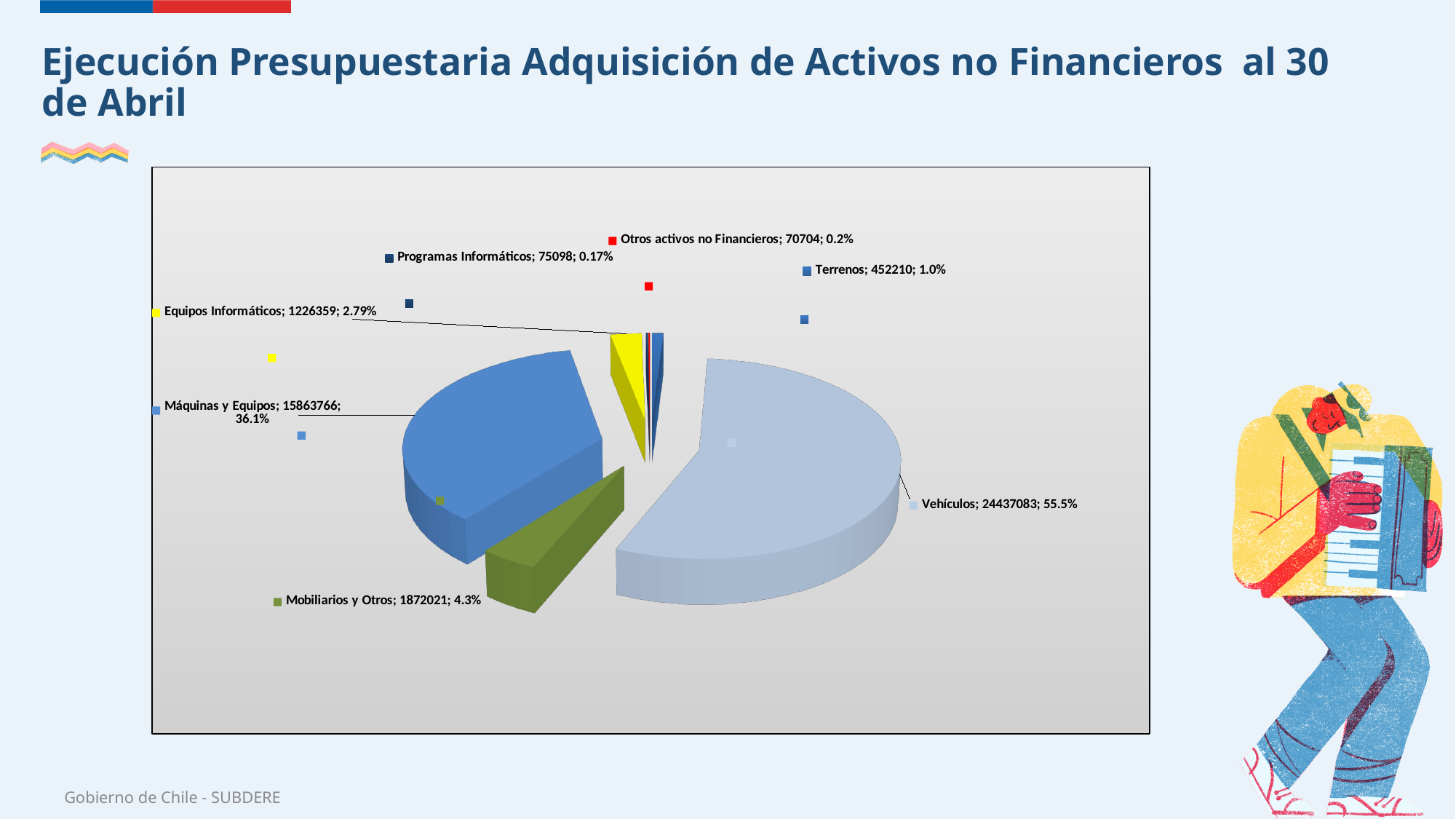
What percentage is shown for Programas Informáticos? 0.17% What share of the pie does Máquinas y Equipos represent? 36.1% What percentage is shown for Equipos Informáticos? 2.79% What kind of chart is shown on the slide? pie chart Which category has the largest slice of the pie? Vehículos Which is larger, the value for Mobiliarios y Otros or the value for Equipos Informáticos? Mobiliarios y Otros Which category has the smallest value? Otros activos no Financieros What is the title of the slide containing the chart? Ejecución Presupuestaria Adquisición de Activos no Financieros al 30 de Abril What is the value for Terrenos? 452210 What is the difference between the values for Vehículos and Máquinas y Equipos? 8573317 What is the value for Vehículos? 24437083 How many categories does the pie chart show? 7